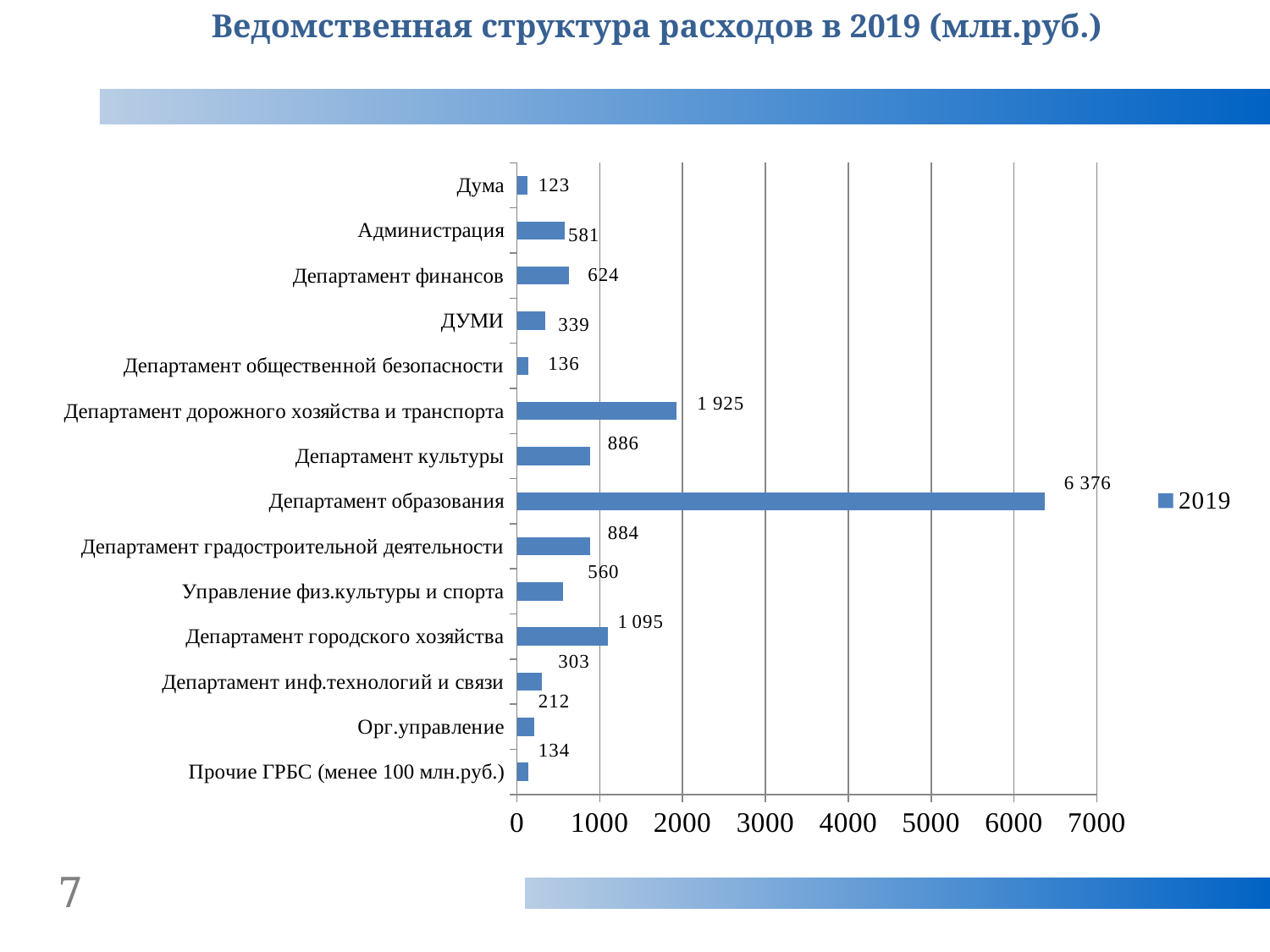
What is the difference between the values for Департамент образования and Департамент дорожного хозяйства и транспорта? 4 451 Is the value for Департамент дорожного хозяйства и транспорта greater or less than 1000? greater How many categories are shown in the chart? 14 Which is larger: the value for Департамент городского хозяйства or the value for Департамент культуры? Департамент городского хозяйства What is the difference between the values for Департамент финансов and Администрация? 43 What kind of chart is shown on the slide? bar chart Which category has the highest value? Департамент образования What is the value for Управление физ.культуры и спорта? 560 What is the value for Департамент дорожного хозяйства и транспорта? 1 925 What is the value for Департамент образования? 6 376 How many series does the legend list? 1 Which category has the lowest value? Дума